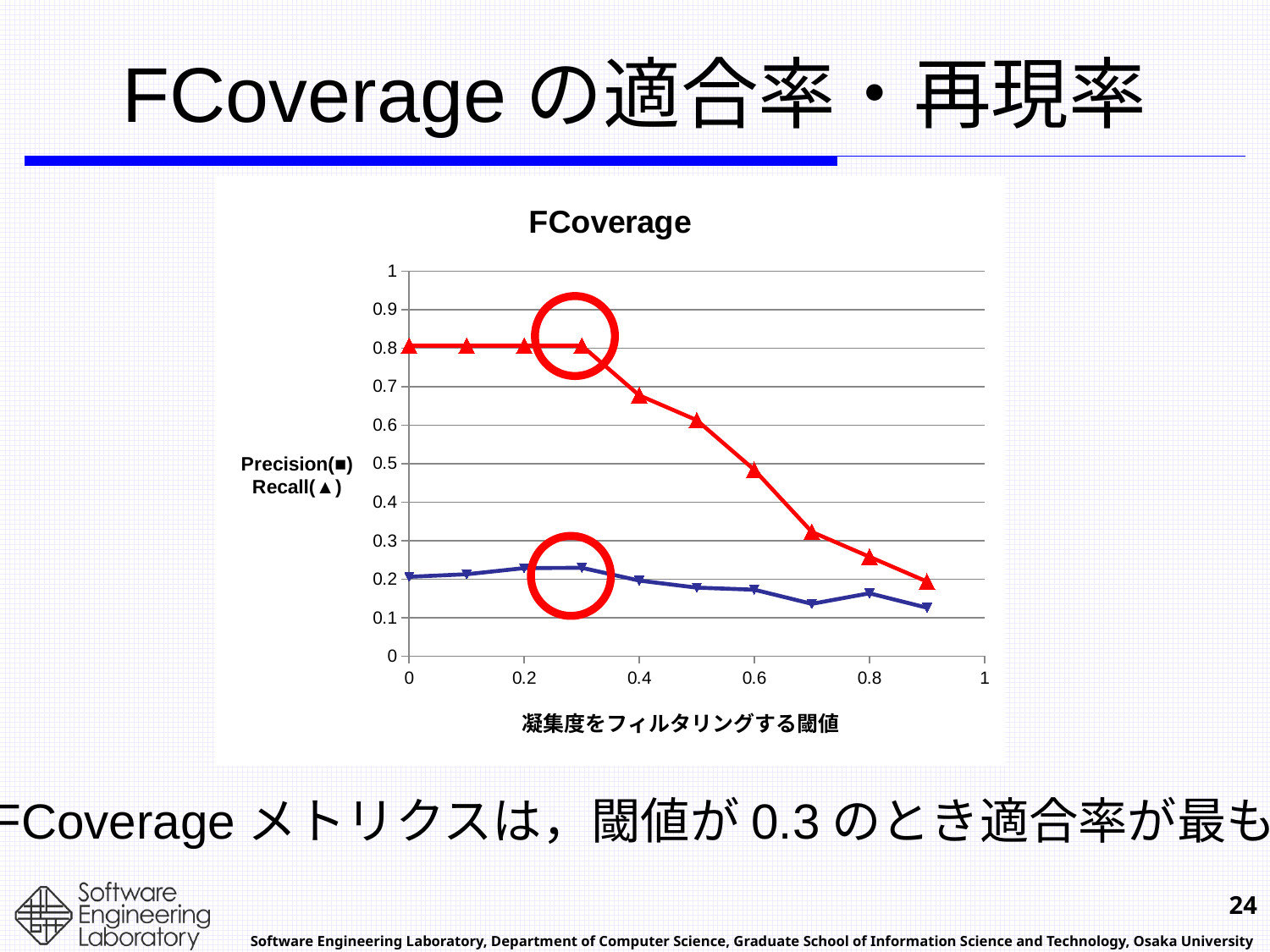
Is the Precision (■) value at threshold 0.5 greater or less than 0.3? less How many series are plotted in the FCoverage chart? 2 How many data points does the Recall (▲) series have? 10 What kind of chart is shown on the slide? line chart Is the Recall (▲) value at threshold 0.7 greater or less than 0.4? less Is the Recall (▲) value at threshold 0.2 greater or less than 0.7? greater At threshold 0.5, which series has the larger value, Precision (■) or Recall (▲)? Recall (▲) What is the title of the chart? FCoverage Does the Recall (▲) series rise or fall as the threshold increases from 0.3 to 0.9? fall At which threshold is the Recall (▲) value lowest? 0.9